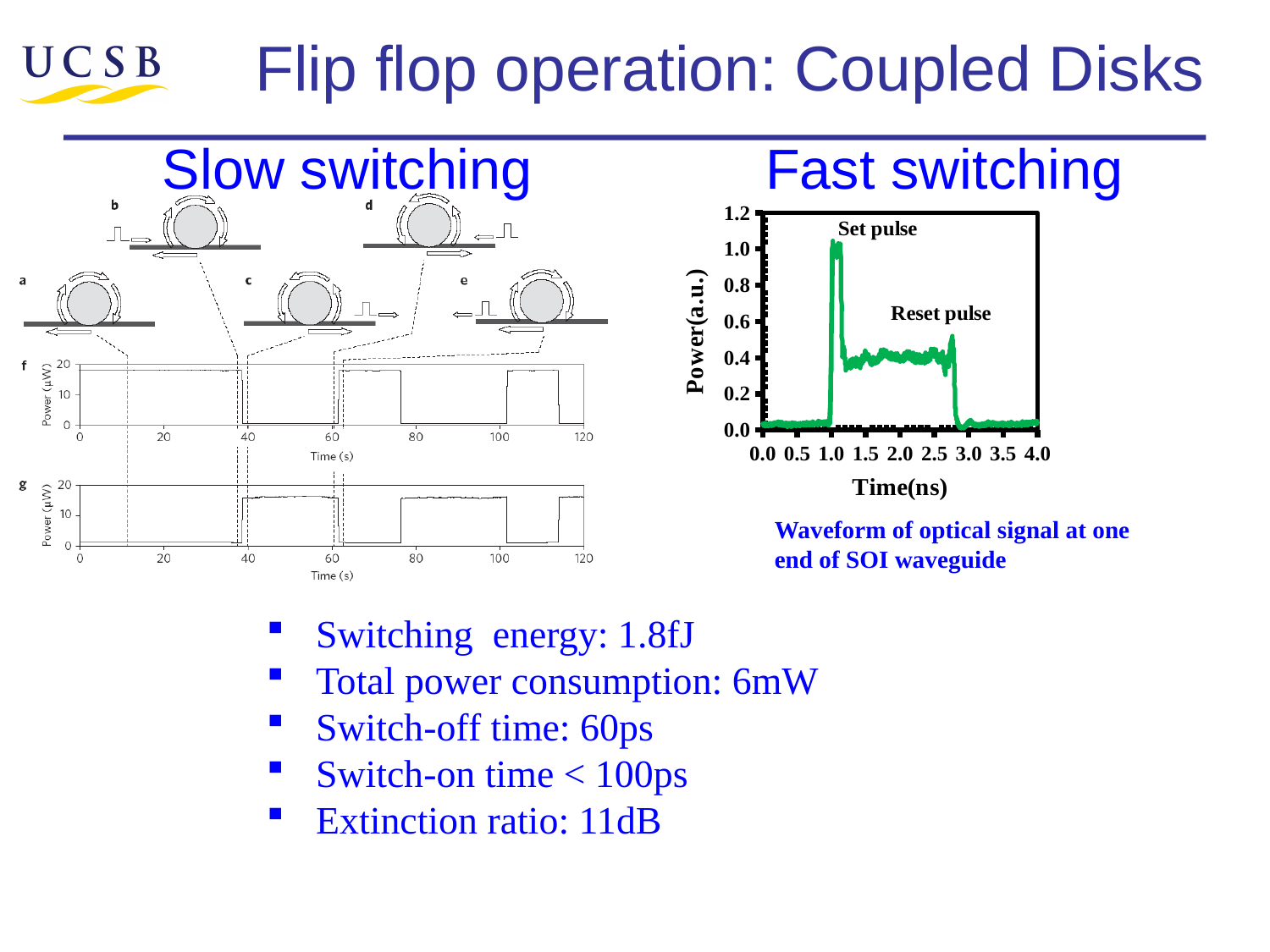
What kind of chart is the Fast switching chart on the right? line chart In the Fast switching chart, what is the highest tick shown on the Time(ns) axis? 4.0 In the Fast switching chart, is the value at 3.5 ns greater or less than 0.2? less What colour is the waveform plotted in the Fast switching chart? green How many power-versus-time plots are shown under Slow switching? 2 In the Slow switching plot f, is the value at 20 s greater or less than 10 µW? greater In the Fast switching chart, is the peak value of the set pulse near 1.0 ns greater or less than 0.8? greater What are the two pulses labelled in the Fast switching chart? Set pulse and Reset pulse In the Fast switching chart, what is the highest tick shown on the Power(a.u.) axis? 1.2